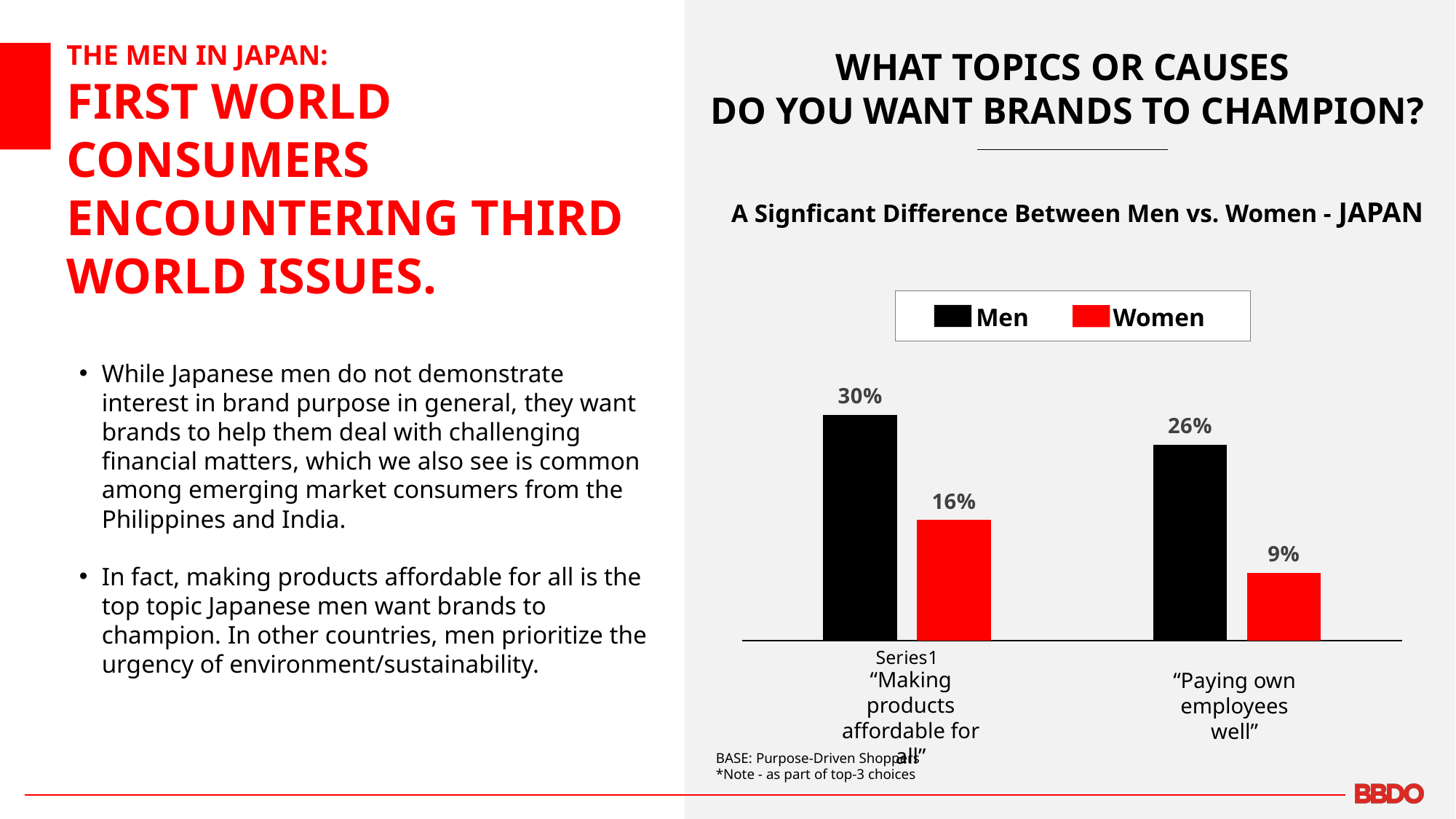
What kind of chart is shown on the slide? Bar chart Which series has the highest value in the chart? Men What is the difference between Men and Women for "Paying own employees well"? 17% What is the value for Men for "Paying own employees well"? 26% Which bar has the lowest value in the chart? Women, "Paying own employees well" Which is larger: the Men value for "Making products affordable for all" or the Men value for "Paying own employees well"? "Making products affordable for all" What is the value for Women for "Paying own employees well"? 9% What is the value for Women for "Making products affordable for all"? 16% What is the difference between Men and Women for "Making products affordable for all"? 14% What colour represents Women in the chart? Red How many series does the legend list? 2 What is the value for Men for "Making products affordable for all"? 30%